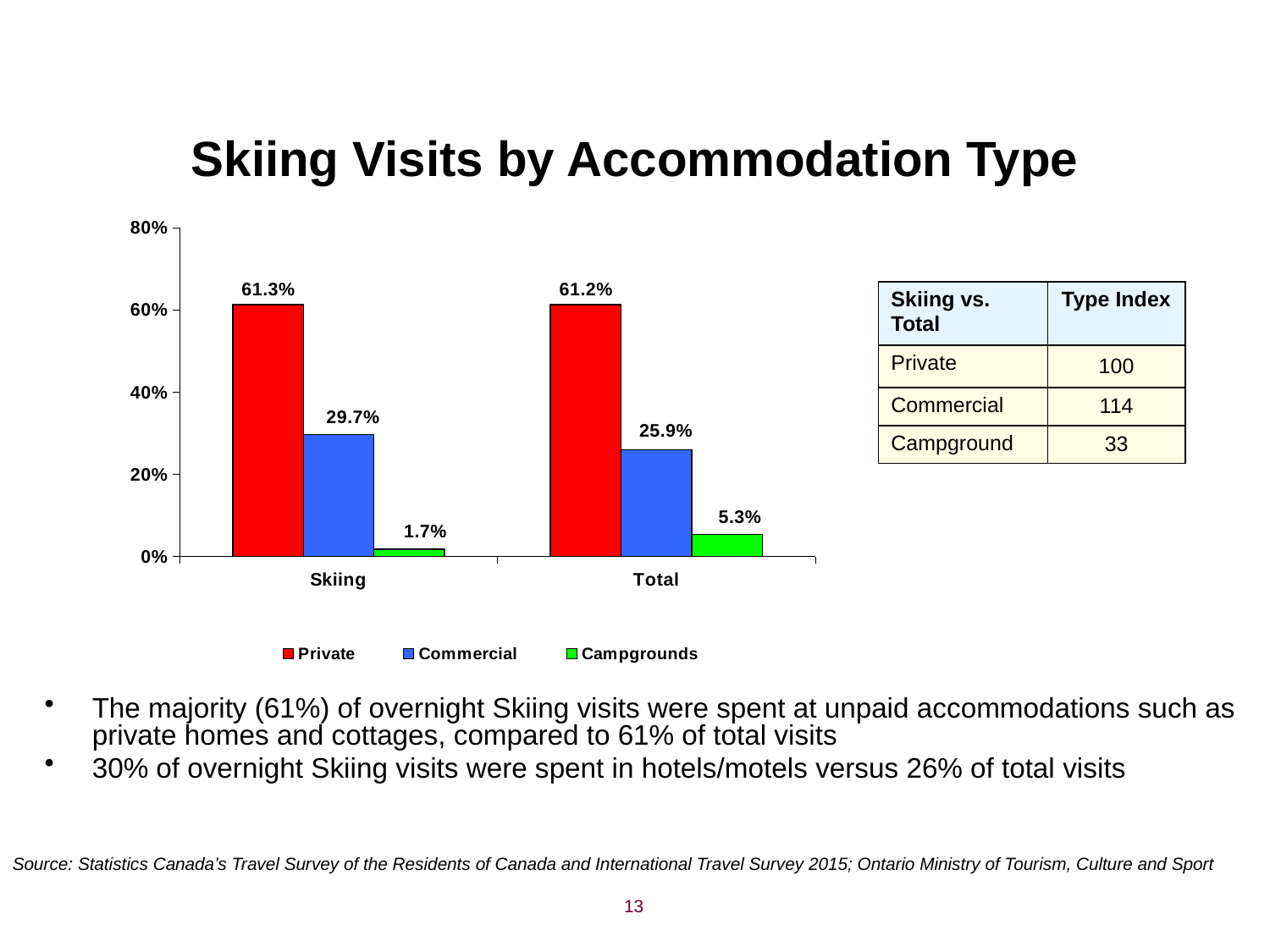
What is the difference between the Commercial values for Skiing and Total? 3.8% Is the value for Commercial in the Skiing group greater or less than 20%? greater Which series has the highest value in the Skiing group? Private What is the value for Commercial in the Total group? 25.9% How many series does the legend list? 3 Which series has the lowest value in the Total group? Campgrounds What is the value for Campgrounds in the Skiing group? 1.7% How many categories are shown on the x axis? 2 Which is larger, the Campgrounds value for Skiing or for Total? Total What is the value for Private in the Skiing group? 61.3% What colour are the Private bars? red What kind of chart is shown? bar chart